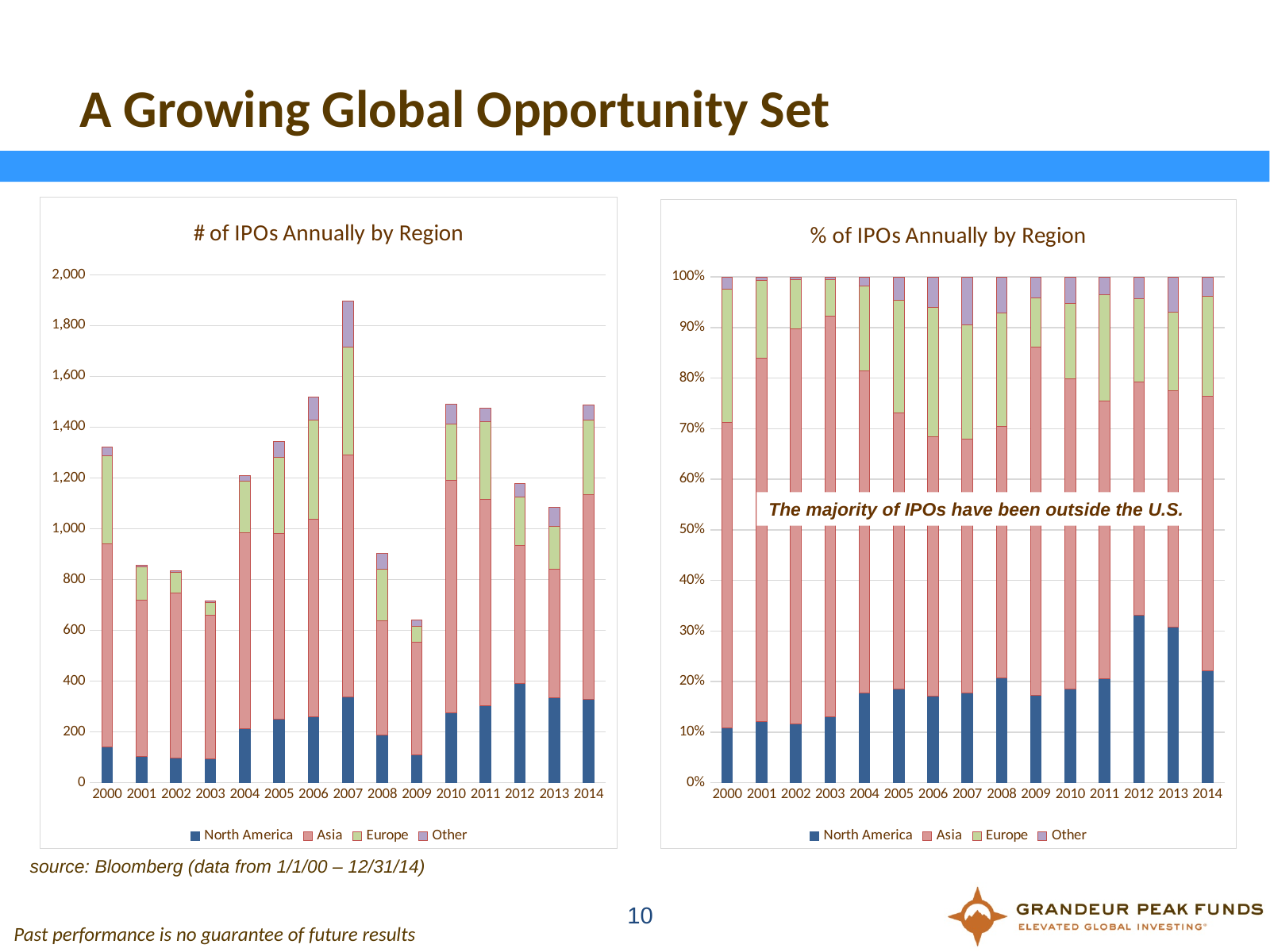
In the '# of IPOs Annually by Region' chart, how many years are shown on the x axis? 15 In the '# of IPOs Annually by Region' chart, how many series does the legend list? 4 In the '% of IPOs Annually by Region' chart, is the North America share for 2012 greater or less than 30%? greater In the '% of IPOs Annually by Region' chart, is the North America share for 2000 greater or less than 20%? less In the '# of IPOs Annually by Region' chart, is the total for 2007 greater or less than 1,800? greater In the '# of IPOs Annually by Region' chart, which year has the larger total, 2007 or 2008? 2007 In the '# of IPOs Annually by Region' chart, which year has the highest total number of IPOs? 2007 What annotation text is printed inside the '% of IPOs Annually by Region' chart? The majority of IPOs have been outside the U.S. In the '# of IPOs Annually by Region' chart, what kind of chart is shown? Stacked bar chart In the '# of IPOs Annually by Region' chart, which year has the lowest total number of IPOs? 2009